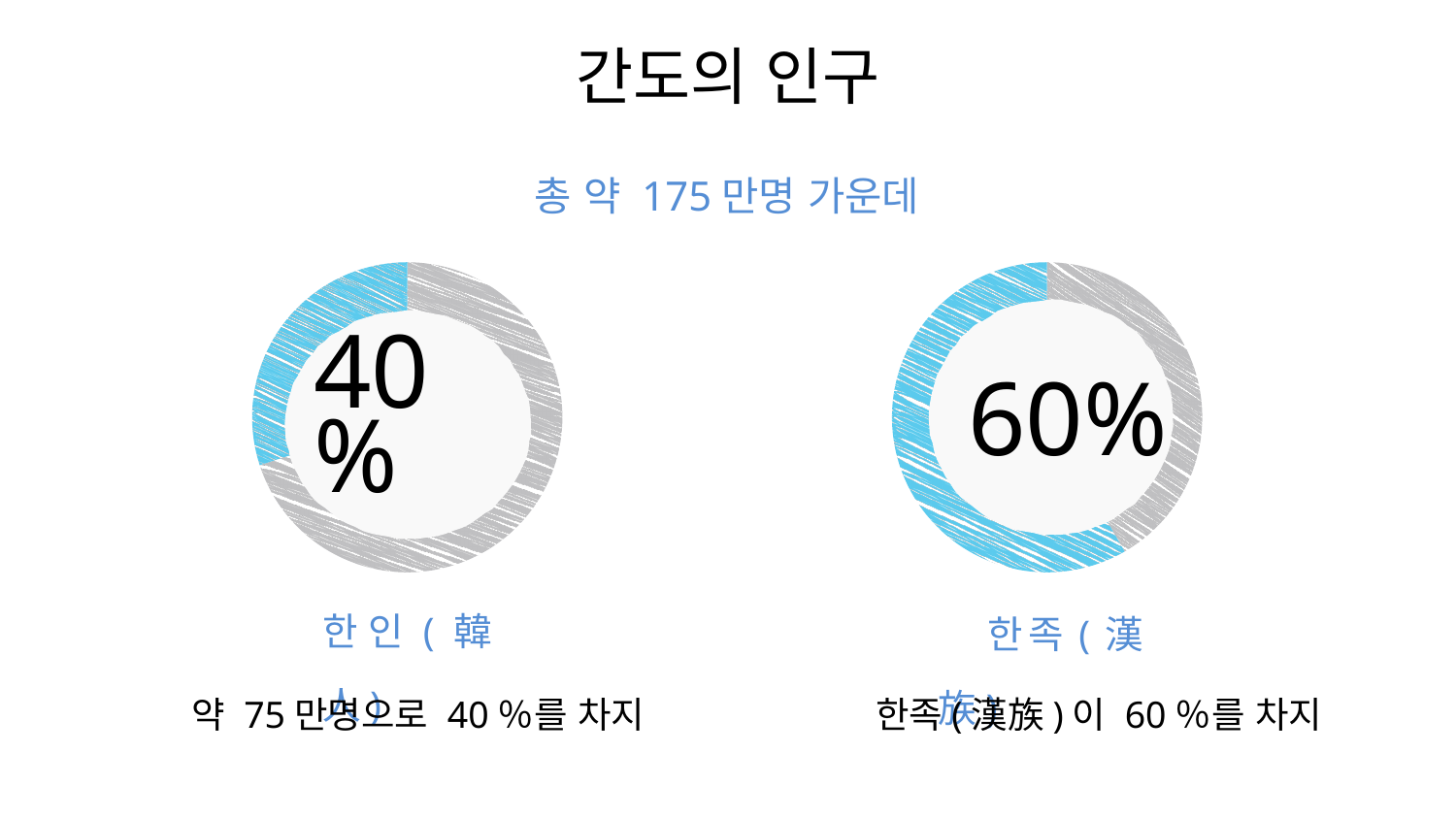
What is the difference in percentage points between the 한족 share (60%) and the 한인 share (40%)? 20 How many donut charts are shown on the slide? 2 Is the value shown in the right donut chart (한족) greater or less than 50%? greater What is the title of the slide? 간도의 인구 According to the text under the left chart, how many people does the 40% 한인 share correspond to? 약 75만명 Is the value shown in the left donut chart (한인) greater or less than 50%? less Which group has the larger share of the population, 한인 or 한족? 한족 What percentage is shown in the centre of the right donut chart (한족)? 60% What kind of chart is used on this slide to show the population shares? Donut (pie) chart What is the total population stated above the charts? 약 175만명 What percentage is shown in the centre of the left donut chart (한인)? 40% What colour is used for the filled (highlighted) portion of each donut chart? Blue